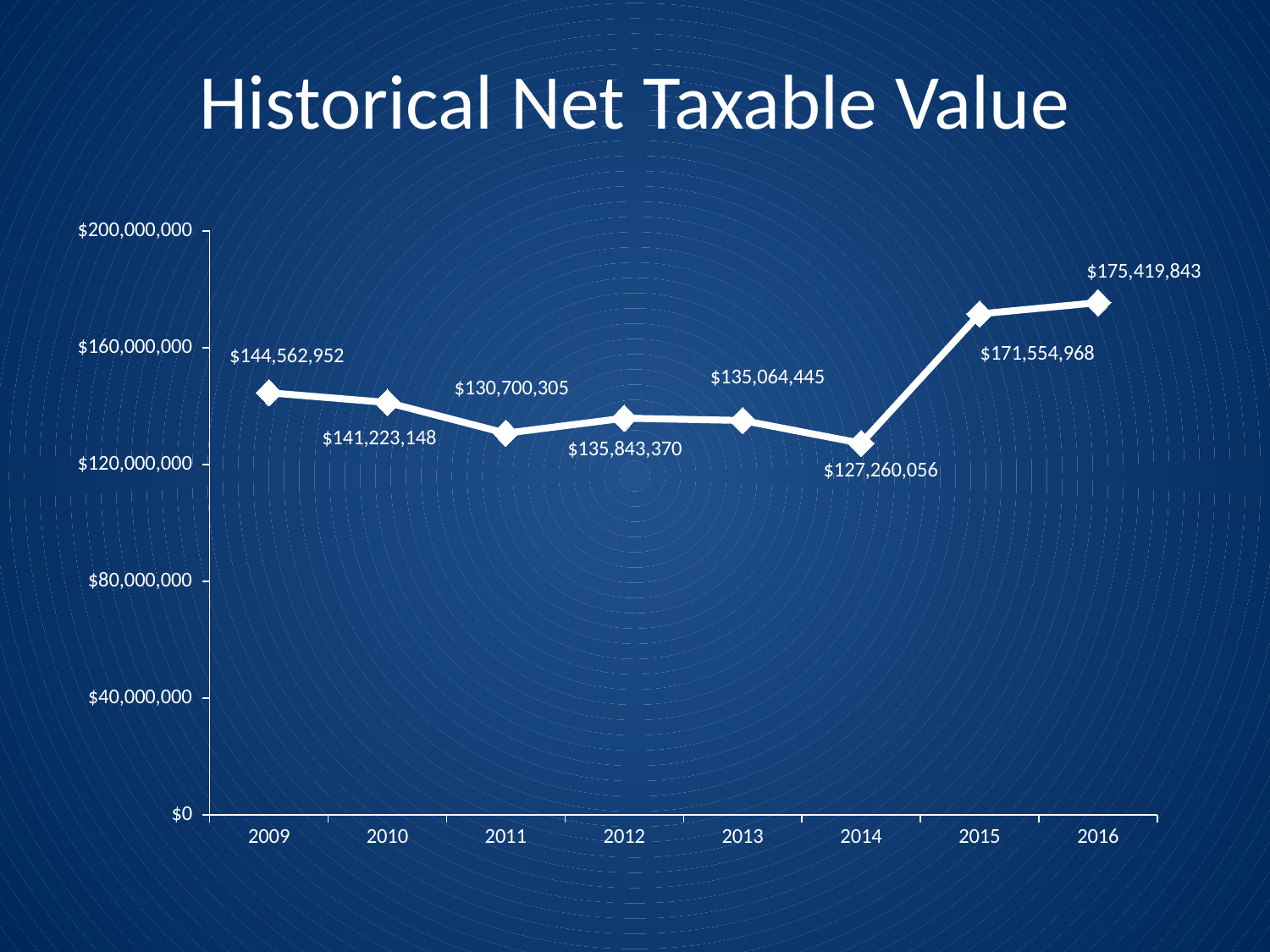
Is the net taxable value for 2015 greater or less than $160,000,000? greater What is the difference between the net taxable value in 2016 and in 2015? $3,864,875 What is the net taxable value for 2016? $175,419,843 Which year has the highest net taxable value? 2016 What is the difference between the net taxable value in 2009 and in 2014? $17,302,896 What is the net taxable value for 2014? $127,260,056 What kind of chart is shown on the slide? line chart What is the net taxable value for 2009? $144,562,952 Which year has a larger net taxable value, 2010 or 2011? 2010 Which year has the lowest net taxable value? 2014 How many years are plotted on the chart? 8 What is the net taxable value for 2012? $135,843,370